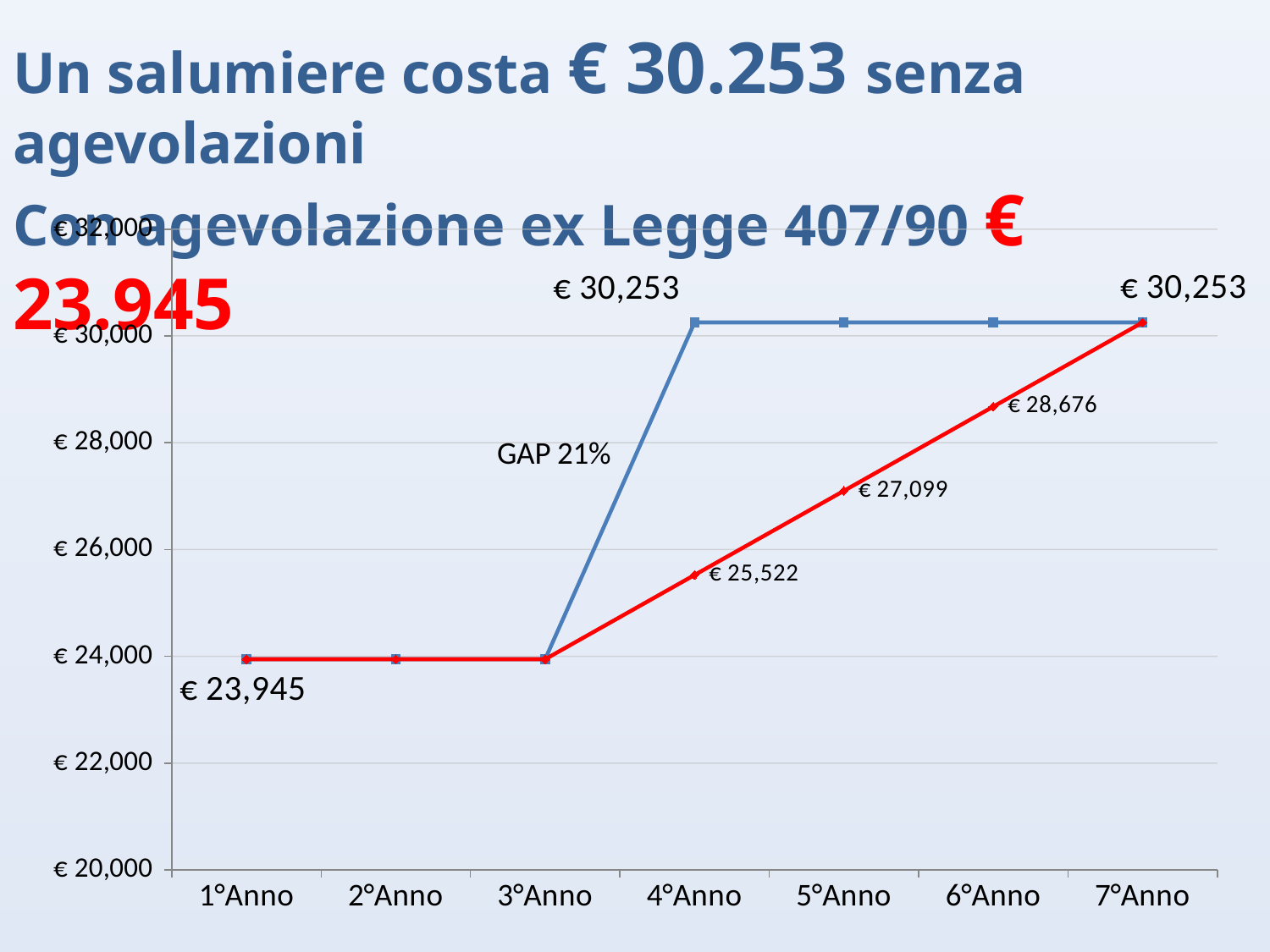
What kind of chart is shown on the slide? line chart What is the value of the red line at 6°Anno? € 28,676 What is the value of the red line at 4°Anno? € 25,522 What is the difference between the blue line and the red line at 4°Anno? € 4,731 How many years (categories) are shown on the x axis of the chart? 7 What gap percentage is annotated between the two lines on the chart? GAP 21% What is the value of the red line at 5°Anno? € 27,099 Is the value of the blue line at 2°Anno greater or less than € 26,000? less What value is labelled at 1°Anno on the chart? € 23,945 What is the value of the blue line at 4°Anno? € 30,253 Does the red line rise or fall from 3°Anno to 7°Anno? rises At 5°Anno, which line has the higher value, the blue line or the red line? the blue line